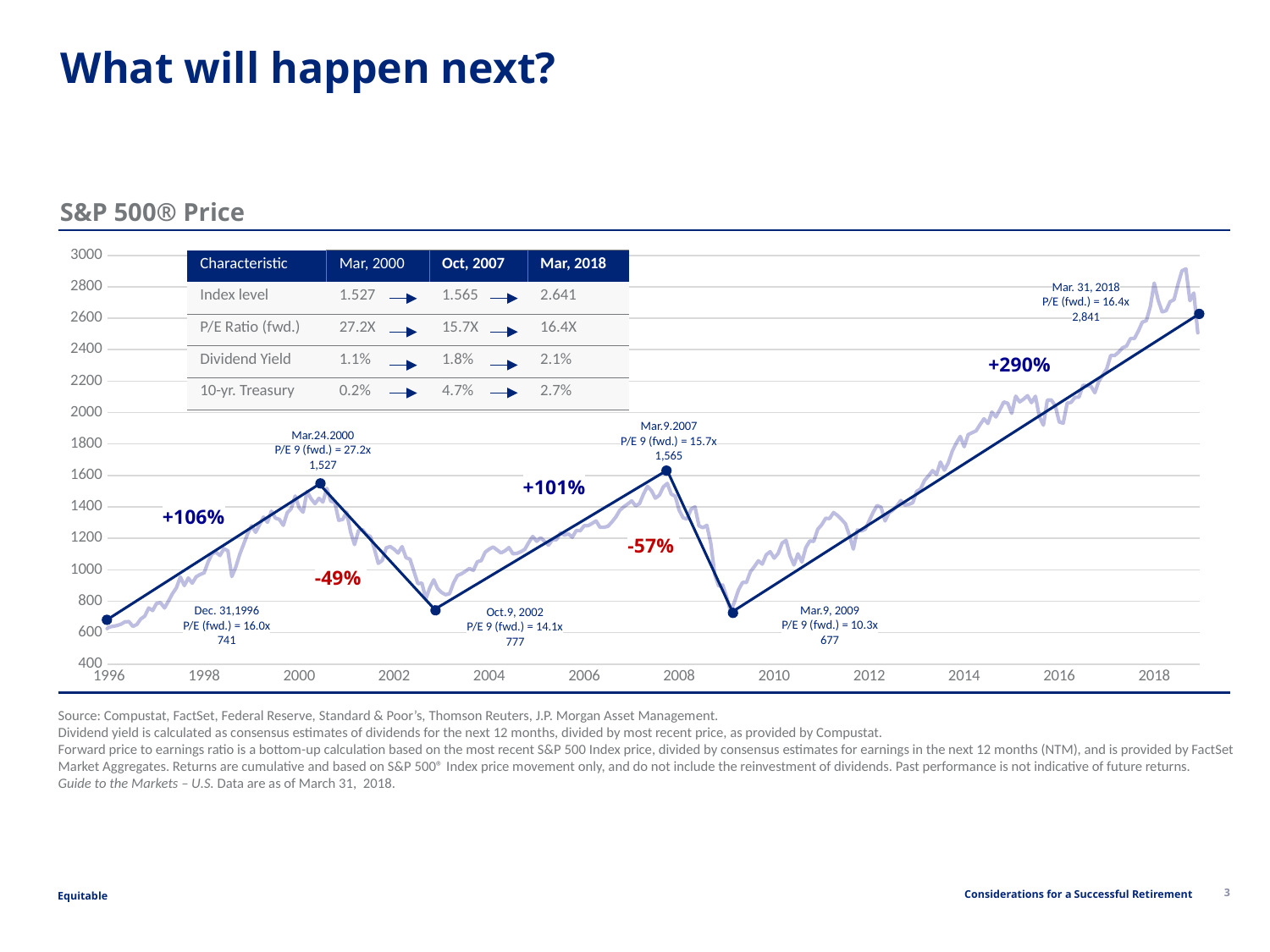
What type of chart is shown on the slide? line chart What S&P 500 price level is labeled at Mar. 9, 2009? 677 What percentage change is labeled for the move from the Mar. 9, 2009 low to Mar. 31, 2018? +290% What S&P 500 price level is labeled at Oct. 9, 2002? 777 What percentage change is labeled for the decline from the 2007 peak to the 2009 low? -57% What S&P 500 price level is labeled at Dec. 31, 1996? 741 Which labeled low is higher: Oct. 9, 2002 or Mar. 9, 2009? Oct. 9, 2002 Is the S&P 500 price level in 2014 greater or less than 1600? greater What is the title of the chart? S&P 500® Price Which labeled point on the chart has the lowest S&P 500 price level? Mar. 9, 2009 (677) What is the difference between the labeled price levels at Mar. 9, 2007 (1,565) and Mar. 24, 2000 (1,527)? 38 What S&P 500 price level is labeled at Mar. 24, 2000? 1,527